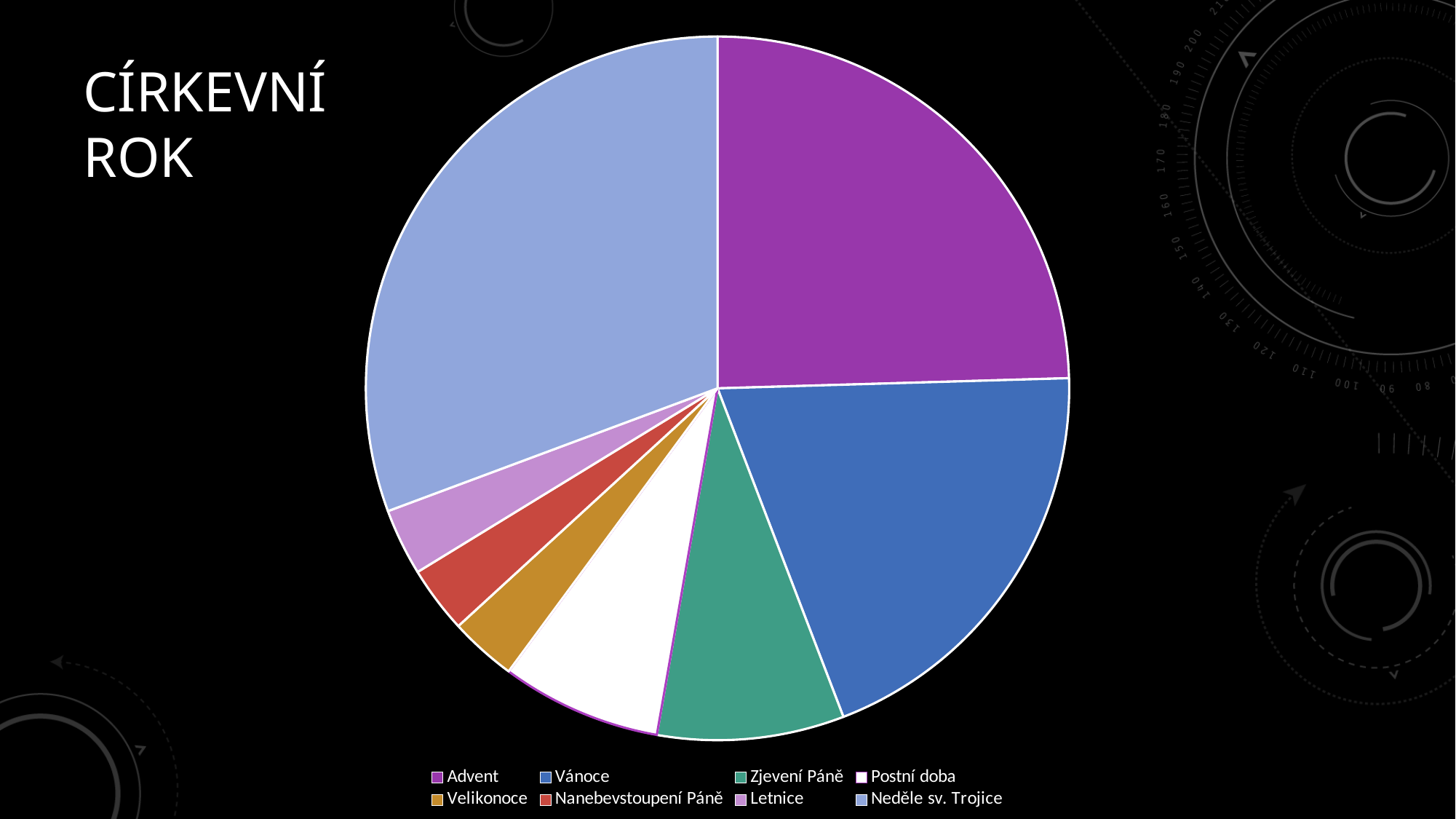
How many categories (slices) does the pie chart have? 8 Which slice is larger, Letnice or Vánoce? Vánoce Which slice is larger, Zjevení Páně or Velikonoce? Zjevení Páně Which slice is larger, Postní doba or Nanebevstoupení Páně? Postní doba What kind of chart is shown on the slide? pie chart Which category has the largest slice of the pie chart? Neděle sv. Trojice What is the title of the slide containing the pie chart? CÍRKEVNÍ ROK Which category is shown in white in the pie chart? Postní doba